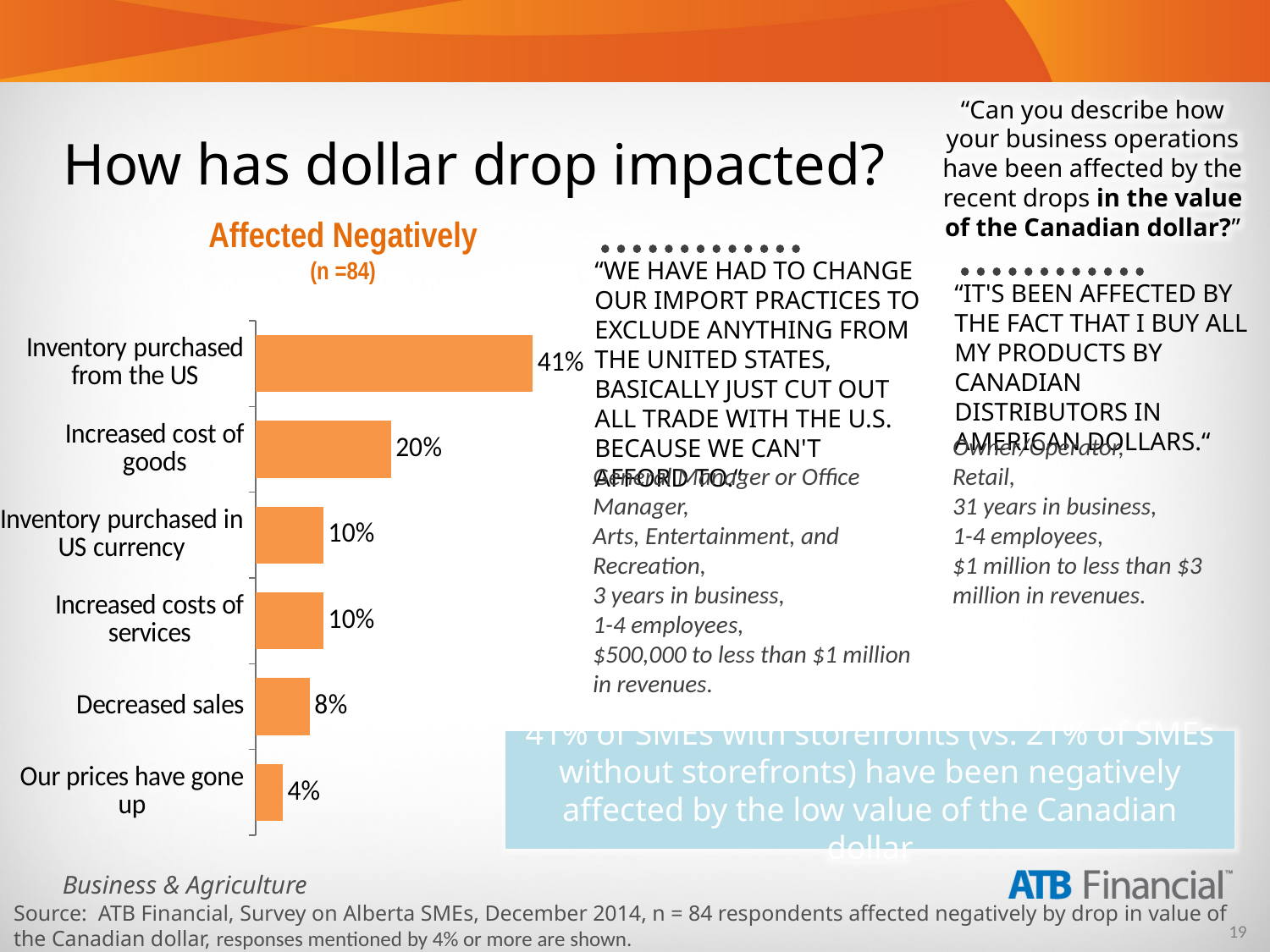
What is the value for 'Our prices have gone up'? 4% Which category has the highest value in the chart? Inventory purchased from the US What percentage of respondents cited inventory purchased from the US as a negative impact? 41% How many categories are shown in the chart? 6 Which category has the lowest value in the chart? Our prices have gone up What is the title of the chart? Affected Negatively What is the value for 'Decreased sales'? 8% What is the sample size (n) shown under the chart title? 84 What is the difference between the values for 'Inventory purchased from the US' and 'Increased cost of goods'? 21% What type of chart is shown on the slide? Bar chart Which is larger: the value for 'Decreased sales' or the value for 'Increased costs of services'? Increased costs of services What is the value for 'Increased cost of goods'? 20%